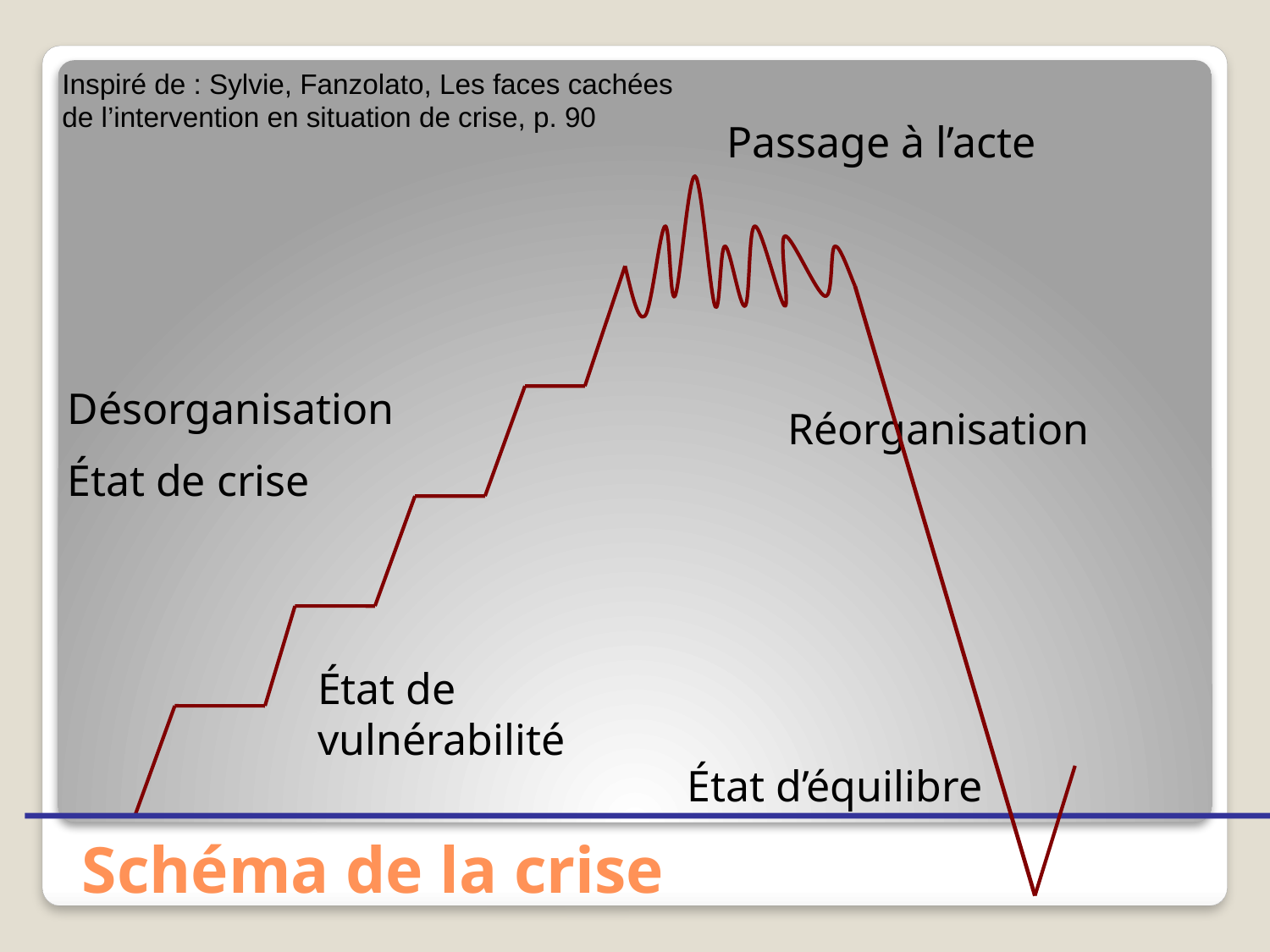
Which label is placed at the highest point of the red line? Passage à l'acte Does the red line rise or fall after the 'Passage à l'acte' peak? falls What is the title of the diagram on the slide? Schéma de la crise Does the red line rise or fall from left to right before reaching its peak? rises How many stage labels are written on the diagram? 6